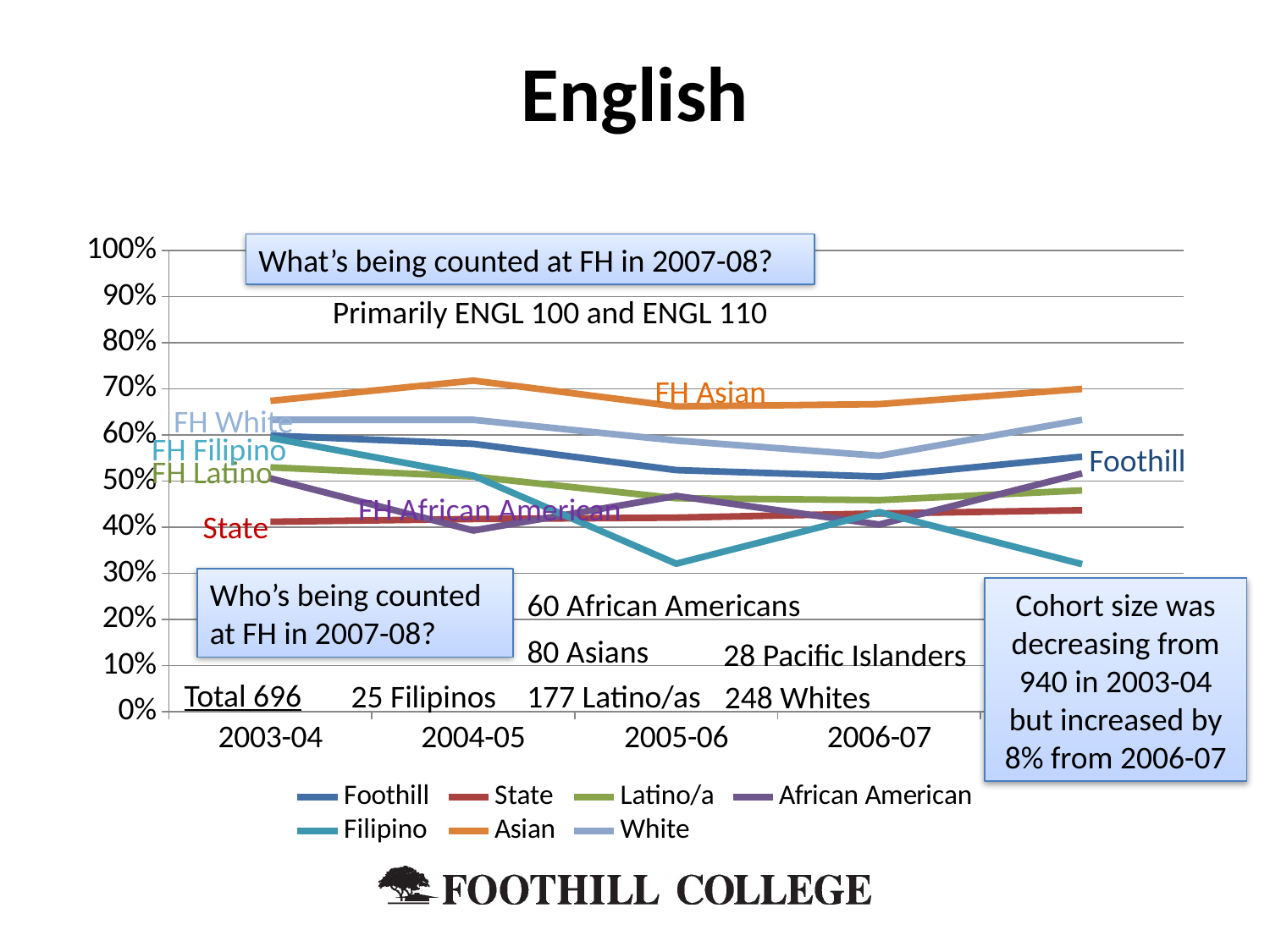
What colour is the Asian line in the legend? orange In 2006-07, which is larger: the Asian value or the State value? Asian Is the value for State in 2003-04 greater or less than 50%? less How many series does the legend list? 7 Is the value for White in 2006-07 greater or less than 50%? greater Which series has the lowest value in 2005-06? Filipino Does the Filipino line rise or fall from 2003-04 to 2005-06? fall Is the value for Filipino in 2005-06 greater or less than 40%? less Which series has the highest value in 2004-05? Asian What kind of chart is shown on the slide? line chart In 2003-04, which is larger: the Foothill value or the State value? Foothill